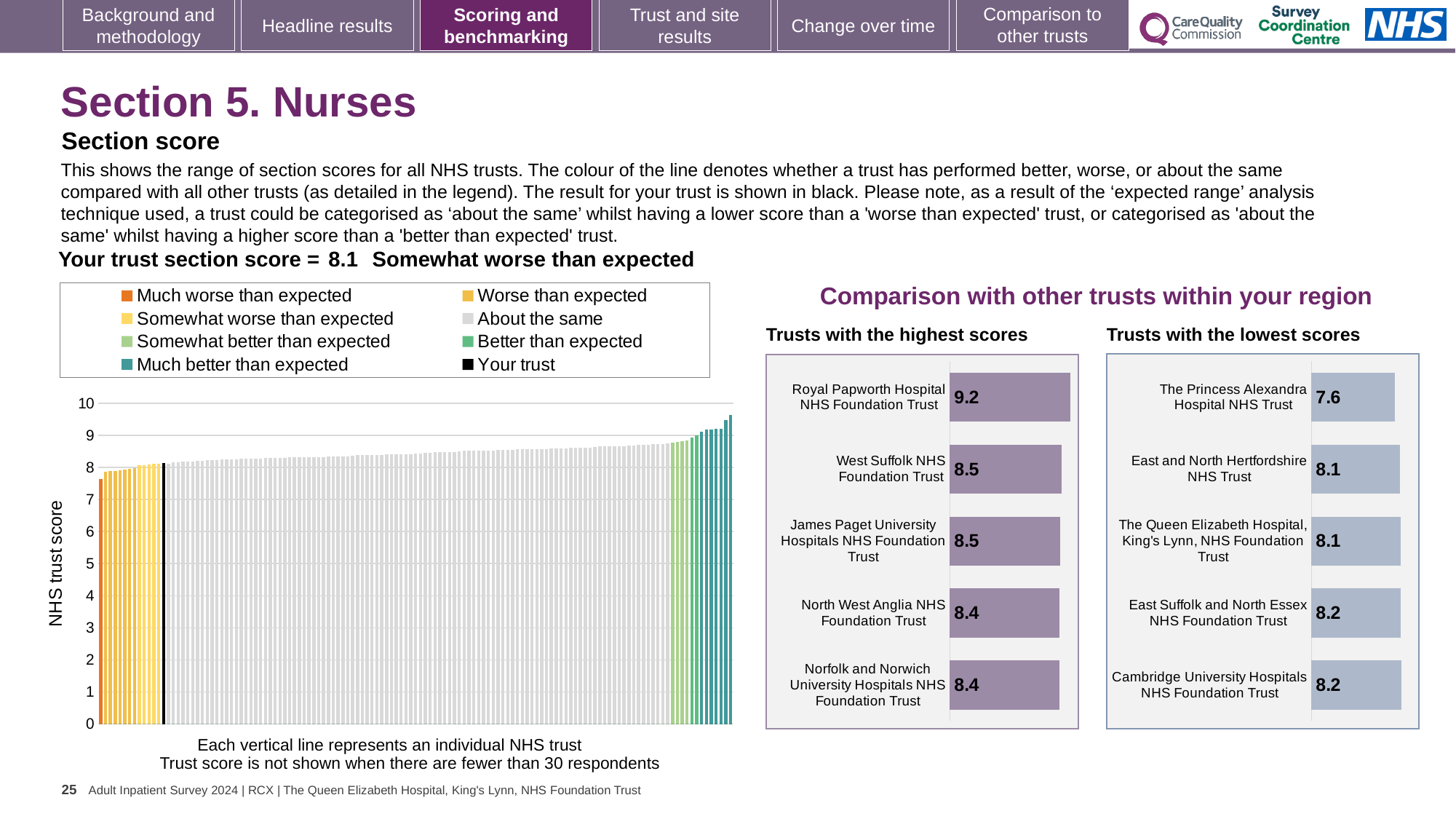
In the 'Trusts with the highest scores' chart, which has the larger score: West Suffolk NHS Foundation Trust or North West Anglia NHS Foundation Trust? West Suffolk NHS Foundation Trust In the 'Trusts with the lowest scores' chart, what is the score for The Princess Alexandra Hospital NHS Trust? 7.6 What kind of chart is the 'Trusts with the highest scores' chart? Bar chart In the 'Trusts with the lowest scores' chart, which trust has the lowest score? The Princess Alexandra Hospital NHS Trust In the NHS trust score chart on the left, do the bars rise or fall from left to right? Rise In the NHS trust score chart on the left, is the value of the tallest bar greater or less than 9? greater In the 'Trusts with the highest scores' chart, which trust has the highest score? Royal Papworth Hospital NHS Foundation Trust In the 'Trusts with the highest scores' chart, what is the score for Royal Papworth Hospital NHS Foundation Trust? 9.2 In the 'Trusts with the highest scores' chart, what is the difference between the scores of Royal Papworth Hospital NHS Foundation Trust and Norfolk and Norwich University Hospitals NHS Foundation Trust? 0.8 In the 'Trusts with the lowest scores' chart, what is the difference between the scores of Cambridge University Hospitals NHS Foundation Trust and The Princess Alexandra Hospital NHS Trust? 0.6 How many entries does the legend of the NHS trust score chart on the left list? 8 How many trusts are shown in the 'Trusts with the lowest scores' chart? 5